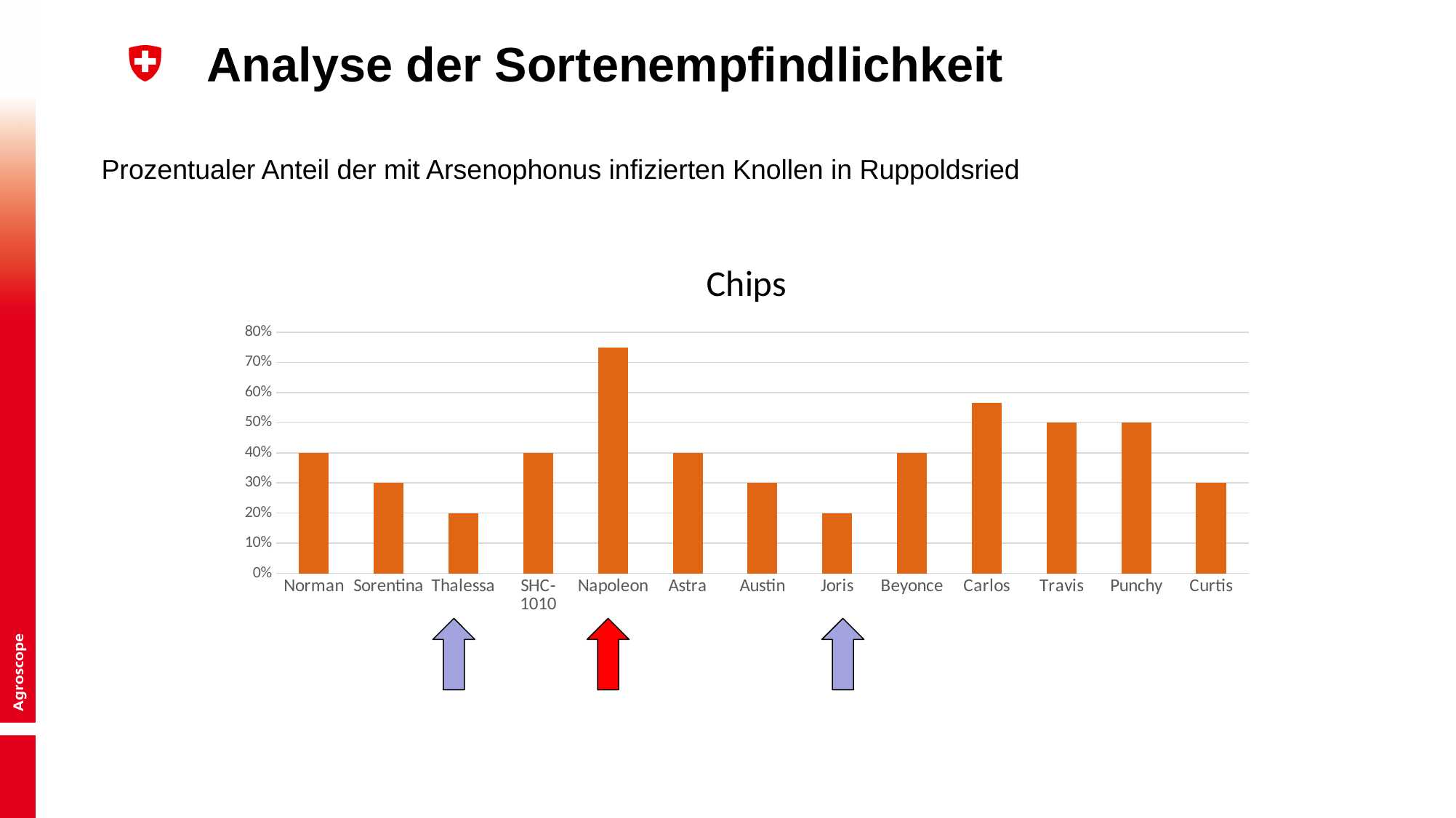
How many varieties (categories) are shown on the x axis of the chart? 13 What is the title of the chart? Chips What is the value for Curtis in the chart? 30% What is the difference between the values for Travis and Joris? 30% Is the value for Carlos greater or less than 60%? less What is the value for Norman in the chart? 40% Is the value for Napoleon greater or less than 70%? greater What is the value for Thalessa in the chart? 20% Which is larger, the value for Punchy or the value for Austin? Punchy What is the value for Travis in the chart? 50% Which variety has the highest percentage of infected tubers in the chart? Napoleon What kind of chart is shown on the slide? bar chart